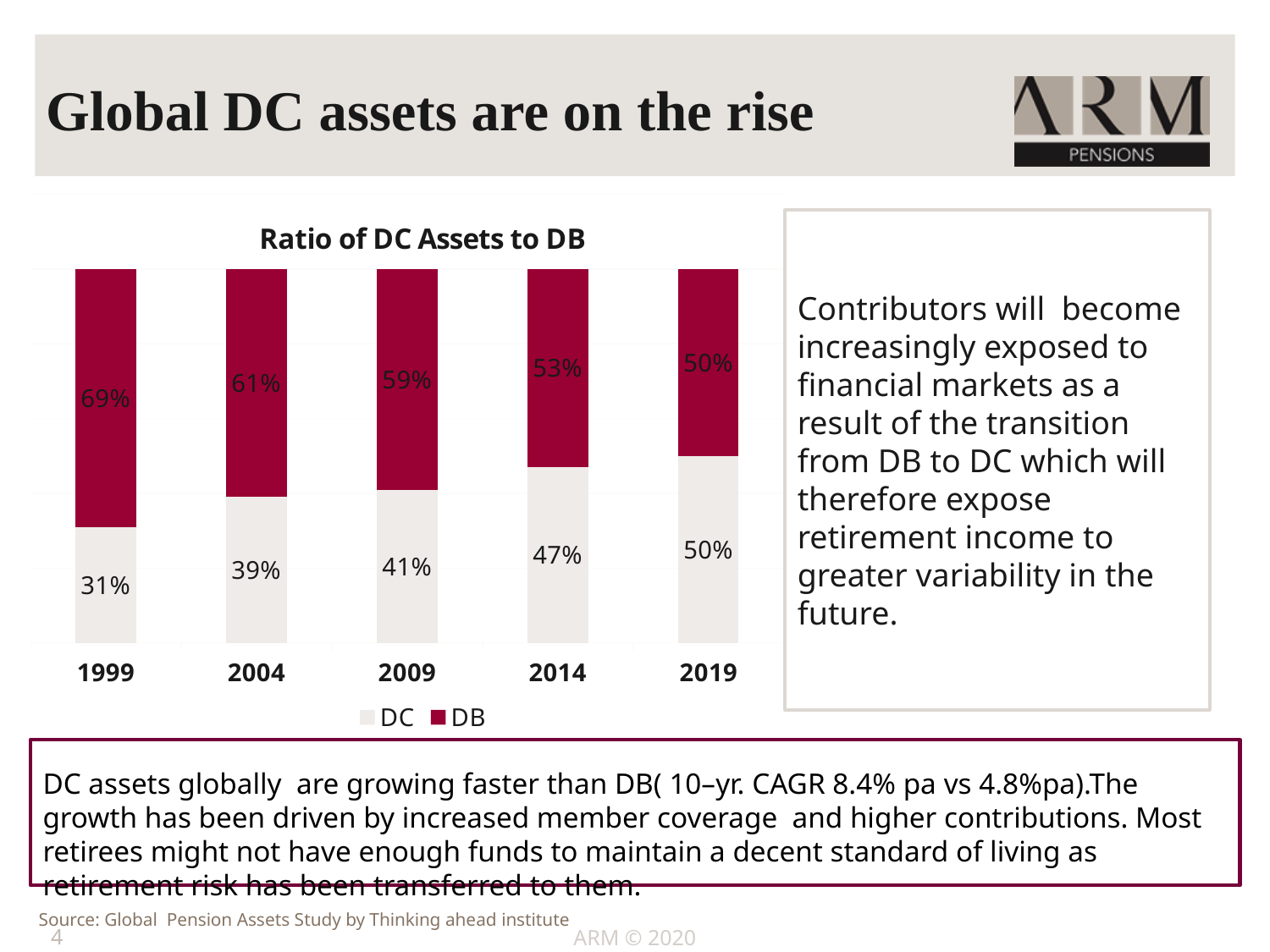
Does the DC share rise or fall from 1999 to 2019? Rise Which is larger in 2014, the DC value or the DB value? DB In which year is the DB share highest? 1999 What is the DC value for 2019? 50% What is the difference between the DB and DC values in 2004? 22% How many years are shown on the x axis? 5 What is the title of the chart? Ratio of DC Assets to DB What is the DC value for 1999? 31% How many series does the legend list? 2 What is the DB value for 2009? 59% In which year is the DC share lowest? 1999 What kind of chart is shown? Stacked bar chart